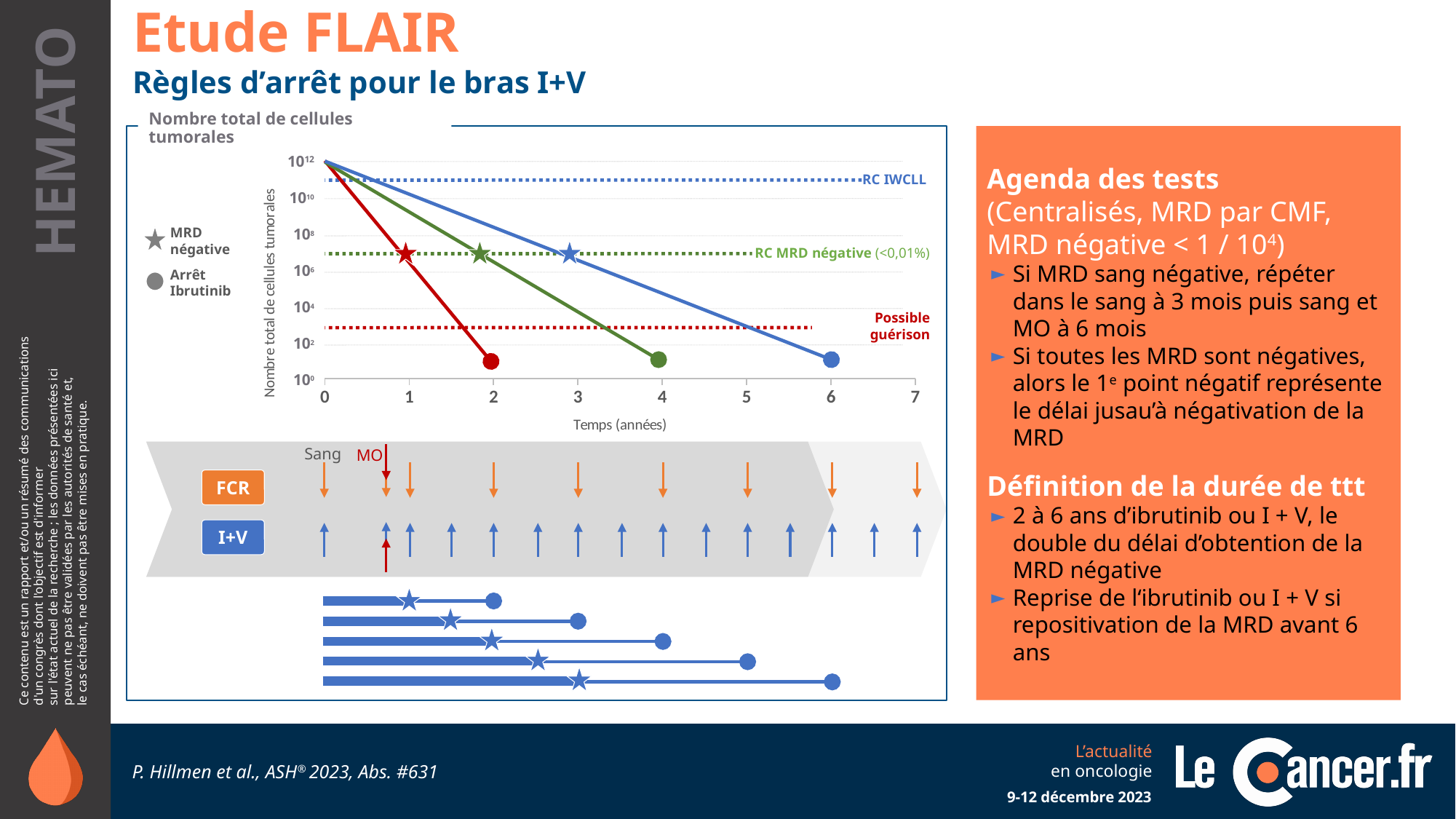
What kind of chart is shown in the 'Nombre total de cellules tumorales' panel? line chart What threshold is given next to the 'RC MRD négative' dotted line? <0,01% At how many years does the blue curve reach its 'Arrêt Ibrutinib' circle? 6 At time 0, what is the total number of tumour cells at which all three curves start? 10¹² Do the tumour-cell curves rise or fall as time (années) increases? fall Which curve reaches the 'Arrêt Ibrutinib' point (circle) latest: red, green or blue? blue Is the time at which the green curve reaches 'Arrêt Ibrutinib' greater or less than 3 years? greater In the chart legend, what does the star symbol represent? MRD négative How many coloured curves are plotted in the tumour-cell chart? 3 Which curve reaches the 'MRD négative' point (star) earliest: red, green or blue? red At how many years does the red curve reach its 'Arrêt Ibrutinib' circle? 2 Is the time at which the blue curve reaches 'MRD négative' (star) greater or less than 2 years? greater